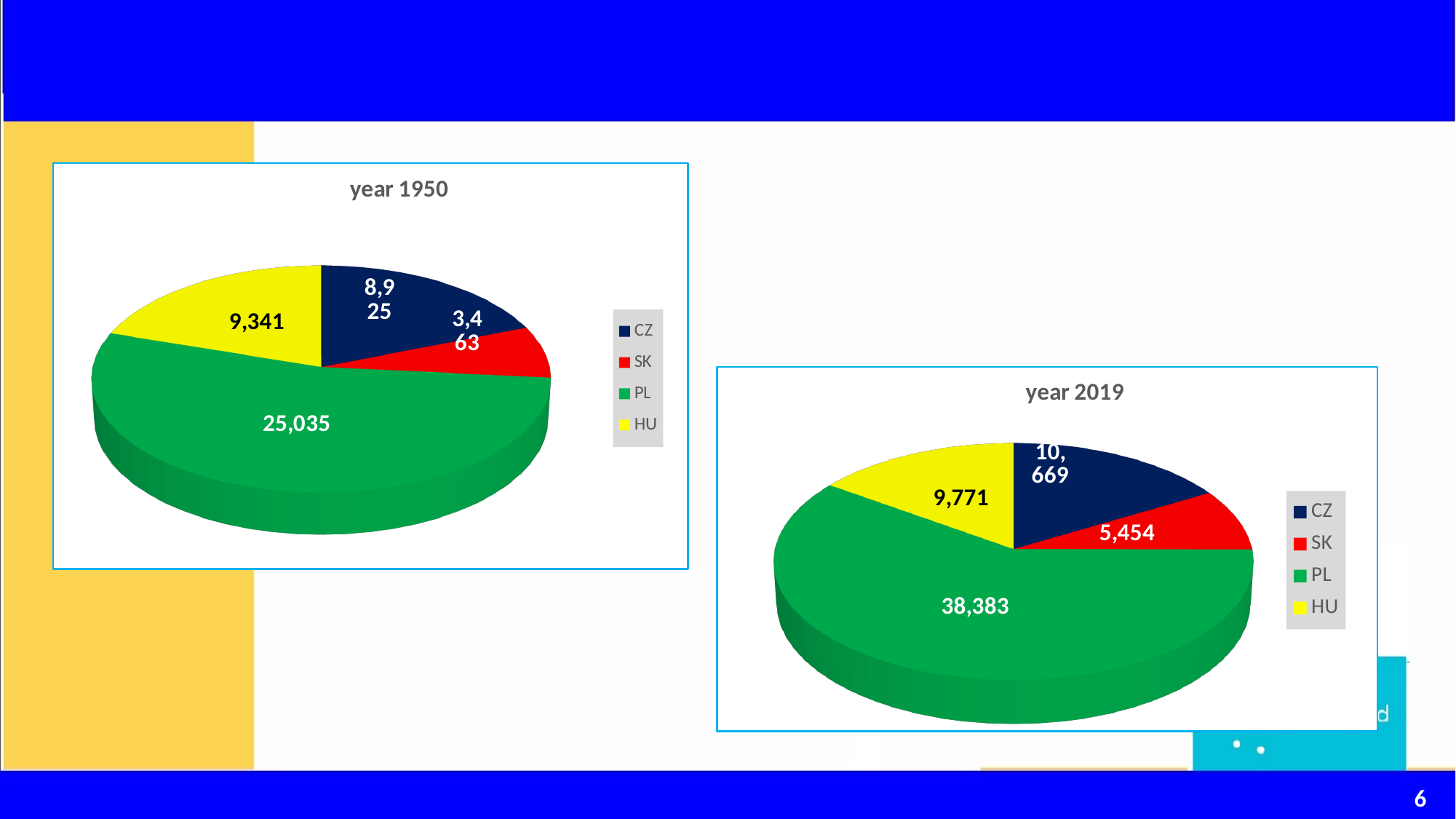
In the 'year 2019' chart, which category has the smallest slice? SK In the 'year 1950' chart, which category has the largest slice? PL What kind of chart is the 'year 1950' chart? Pie chart In the 'year 2019' chart, what is the difference between the values for PL and CZ? 27,714 What is the difference between the PL value in the 'year 2019' chart and the PL value in the 'year 1950' chart? 13,348 In the 'year 1950' chart, which is larger, the value for CZ or the value for SK? CZ In the 'year 2019' chart, what colour is the PL slice? Green How many categories does the 'year 2019' chart show? 4 In the 'year 1950' chart, what is the value for HU? 9,341 In the 'year 1950' chart, what is the value for PL? 25,035 In the 'year 2019' chart, what is the value for SK? 5,454 In the 'year 2019' chart, what is the value for CZ? 10,669